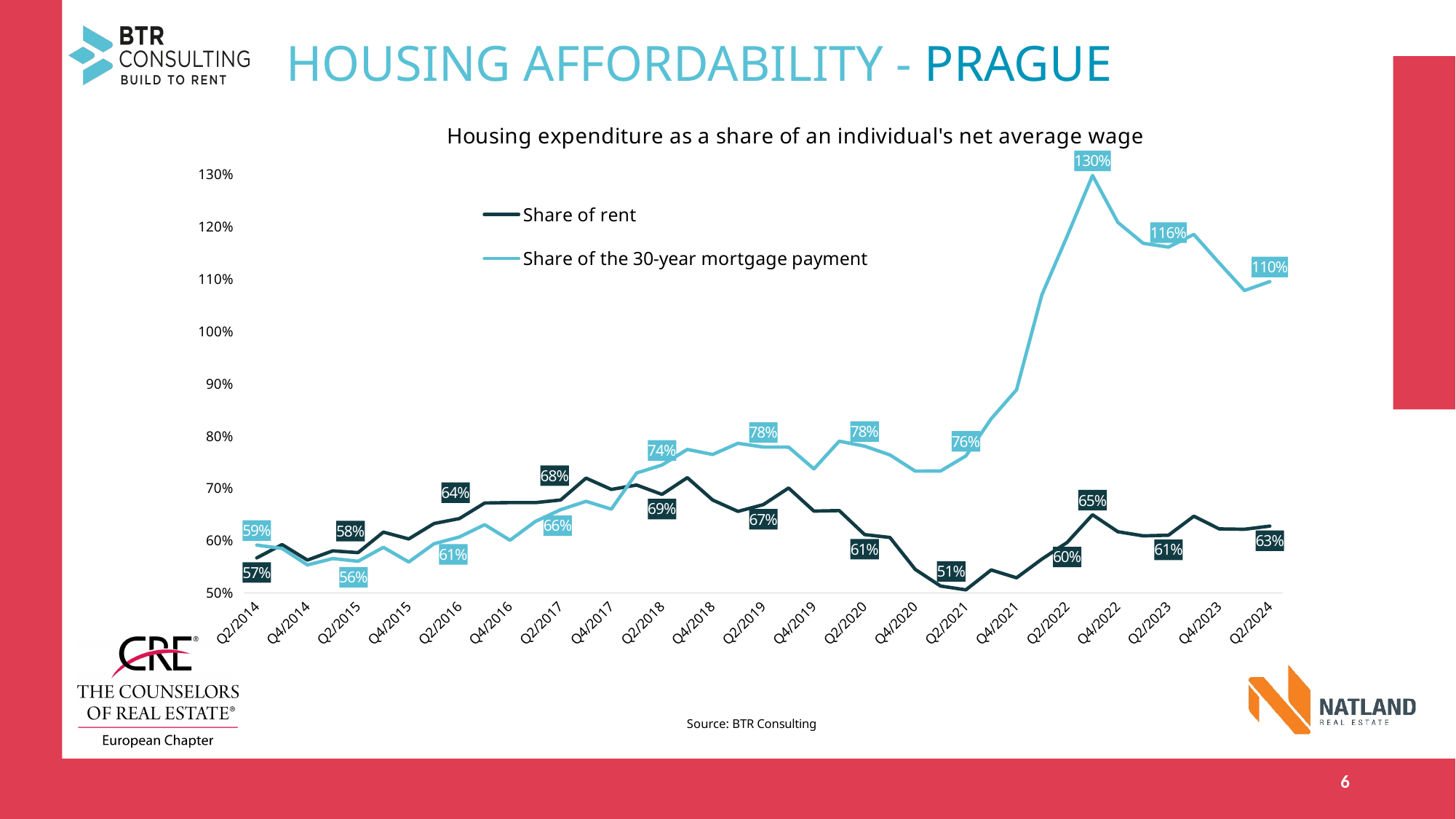
What is the value of Share of rent at Q2/2014? 57% What is the highest labelled value for Share of the 30-year mortgage payment? 130% What is the title of the chart? Housing expenditure as a share of an individual's net average wage What type of chart is shown on the slide? Line chart What is the value of Share of the 30-year mortgage payment at Q2/2024? 110% Does Share of the 30-year mortgage payment rise or fall overall from Q2/2014 to Q2/2024? Rise What is the lowest labelled value for Share of rent? 51% At Q2/2016, which is larger: Share of rent or Share of the 30-year mortgage payment? Share of rent How many series does the legend list? 2 What is the value of Share of rent at Q2/2021? 51% What is the difference between Share of the 30-year mortgage payment and Share of rent at Q2/2024? 47 percentage points Is the value of Share of the 30-year mortgage payment at Q4/2021 greater or less than 80%? greater